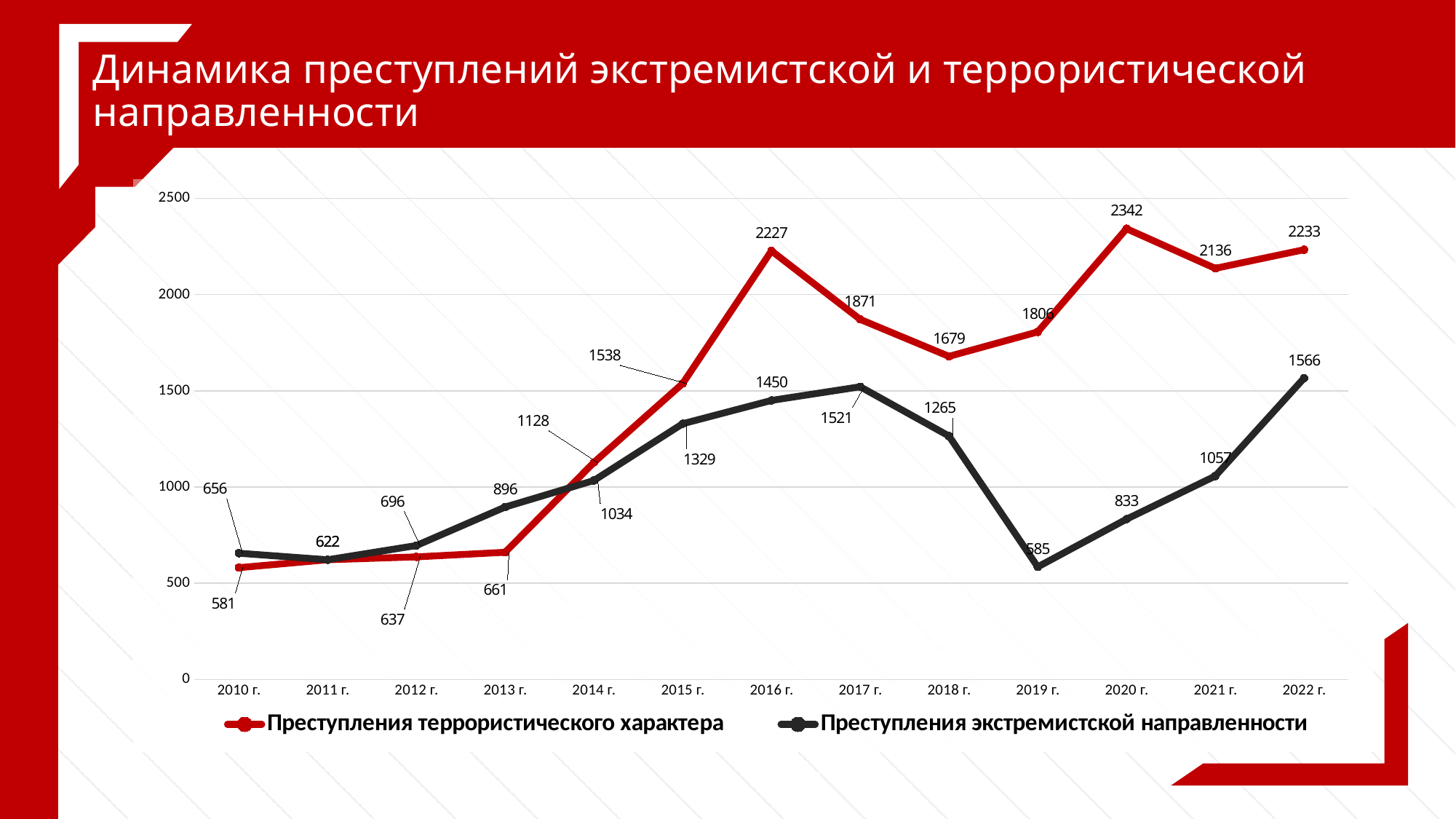
How many years are plotted along the x axis? 13 What is the value for Преступления террористического характера in 2020 г.? 2342 In which year is the value for Преступления экстремистской направленности lowest? 2019 г. Is the value for Преступления террористического характера in 2014 г. greater or less than 1000? greater What is the value for Преступления экстремистской направленности in 2019 г.? 585 Does the value for Преступления экстремистской направленности rise or fall from 2017 г. to 2019 г.? fall What colour is the line for Преступления террористического характера? red How many series does the legend list? 2 In 2013 г., which series has the larger value? Преступления экстремистской направленности What kind of chart is shown on the slide? line chart What is the difference between Преступления террористического характера and Преступления экстремистской направленности in 2016 г.? 777 In which year is the value for Преступления террористического характера highest? 2020 г.